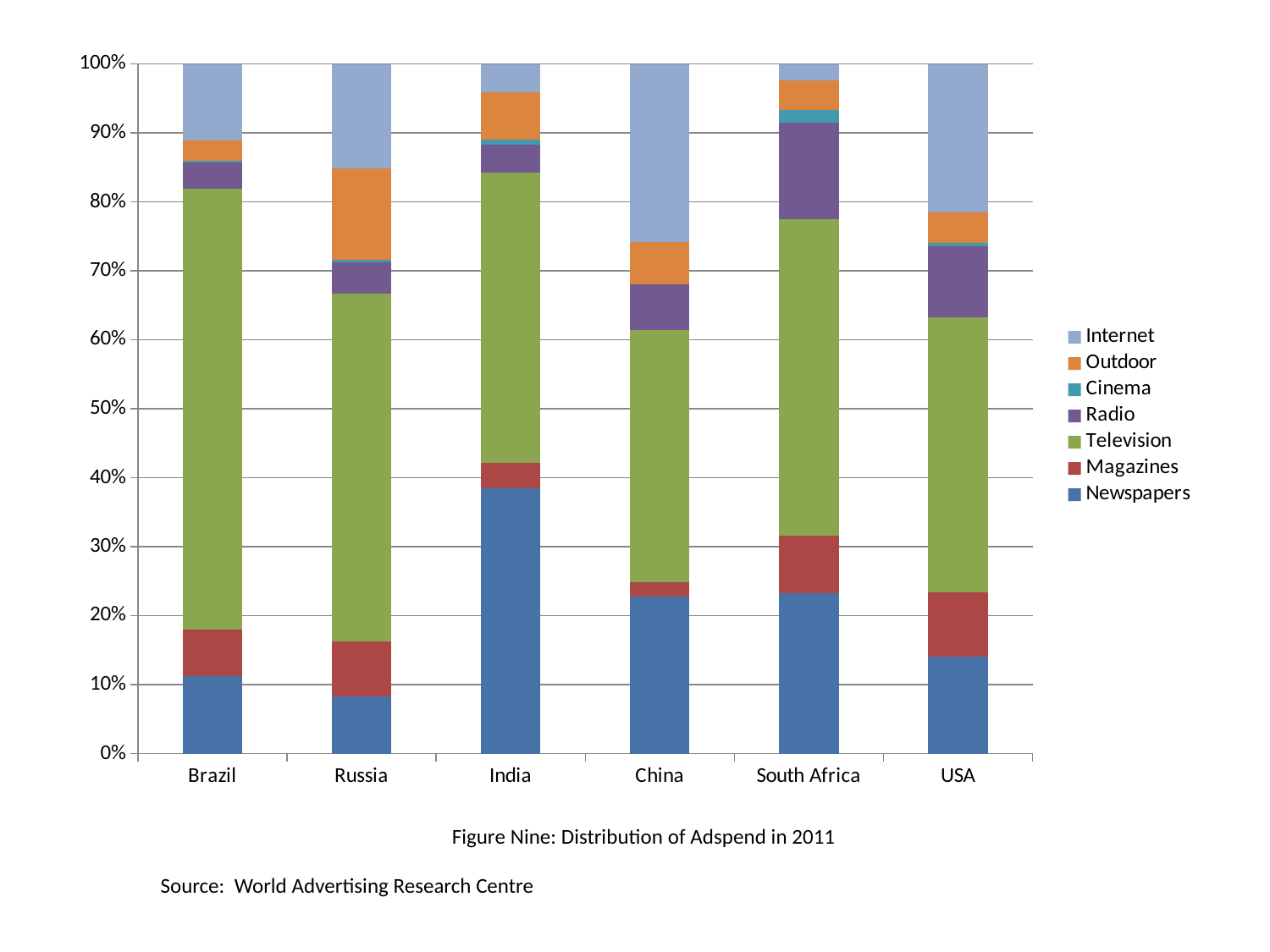
Is the Newspapers share for Russia greater or less than 10%? less Which country has the largest Television share of adspend? Brazil How many series does the legend list? 7 What kind of chart is shown on the slide? Stacked bar chart Which country has the largest Internet share of adspend? China Is the Newspapers share for India greater or less than 30%? greater Which is larger, the Internet share for China or for South Africa? China What is the title of the chart? Figure Nine: Distribution of Adspend in 2011 Which country has the largest Newspapers share of adspend? India How many countries are shown along the x axis? 6 Which country has the smallest Internet share of adspend? South Africa